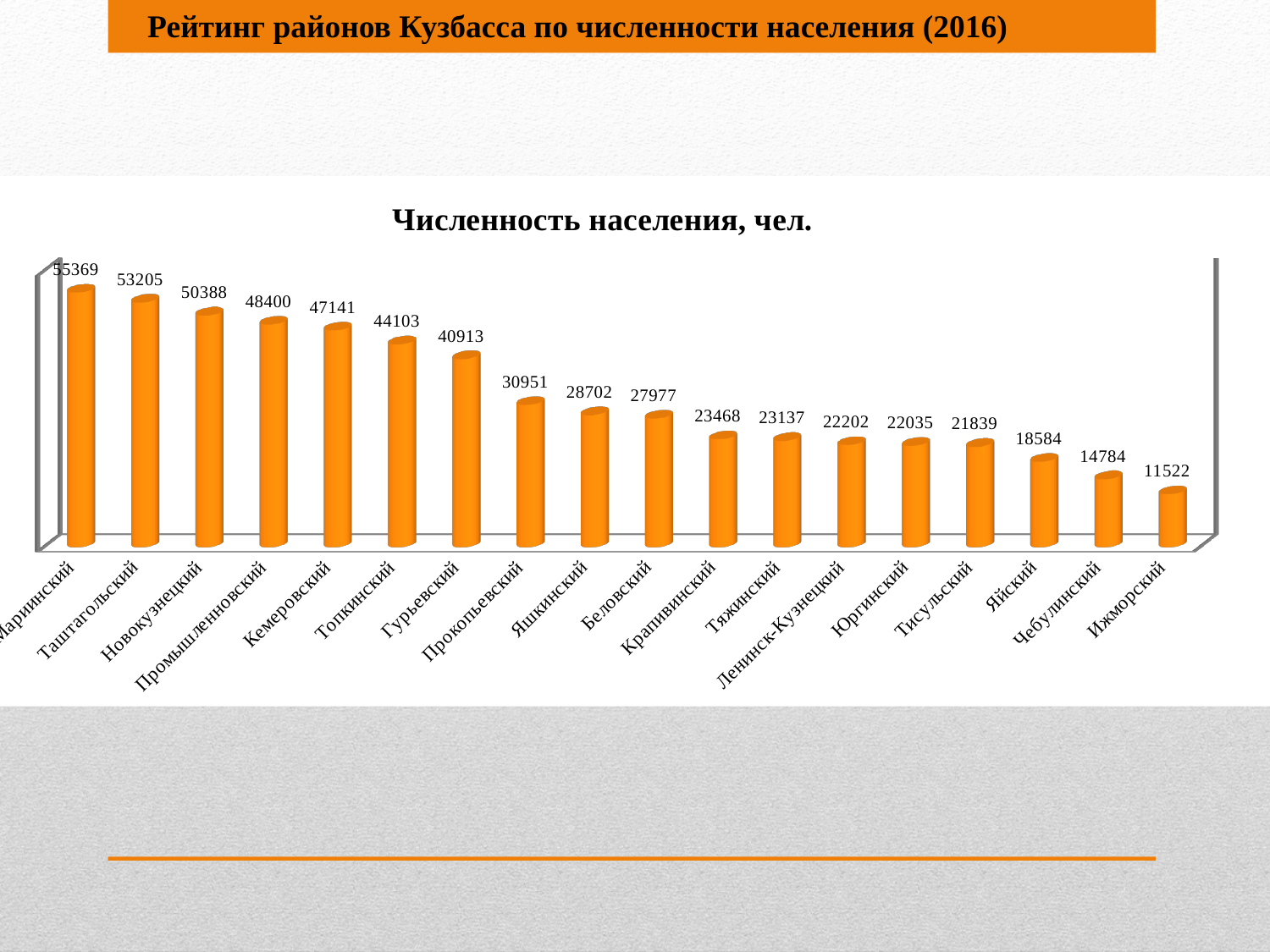
Do the values rise or fall from left to right along the x axis? Fall Which district has the highest population on the chart? Мариинский Which district has the lowest population on the chart? Ижморский Which has a larger value, Гурьевский or Прокопьевский? Гурьевский What kind of chart is shown on the slide? Bar chart How many districts are shown on the chart? 18 What is the title of the chart? Численность населения, чел. What is the value shown for Яйский? 18584 What is the value shown for Прокопьевский? 30951 What is the population value shown for Кемеровский? 47141 What is the difference between the values for Мариинский and Таштагольский? 2164 What is the difference between the values for Чебулинский and Ижморский? 3262